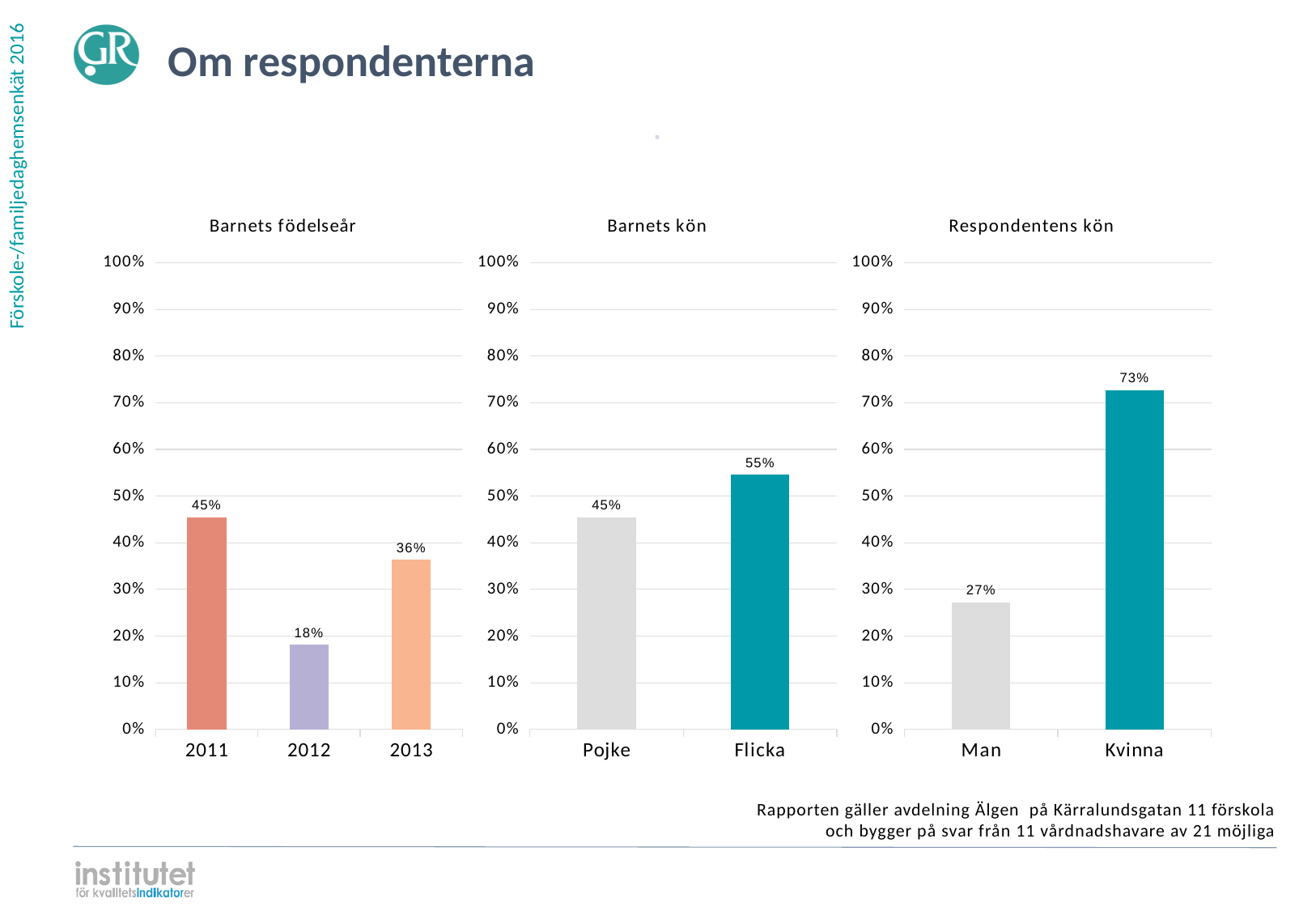
In the 'Barnets födelseår' chart, what is the value for 2011? 45% What is the title of the chart on the left of the slide? Barnets födelseår In the 'Barnets kön' chart, what is the value for Flicka? 55% In the 'Barnets födelseår' chart, what is the difference between the values for 2011 and 2013? 9% In the 'Respondentens kön' chart, which category has the highest value? Kvinna In the 'Respondentens kön' chart, what is the difference between Kvinna and Man? 46% What kind of chart is the 'Respondentens kön' chart? Bar chart In the 'Barnets födelseår' chart, how many categories are shown on the x axis? 3 In the 'Respondentens kön' chart, what is the value for Man? 27% In the 'Barnets kön' chart, which category is higher, Pojke or Flicka? Flicka In the 'Barnets kön' chart, what is the difference between Flicka and Pojke? 10% In the 'Barnets födelseår' chart, which year has the lowest value? 2012